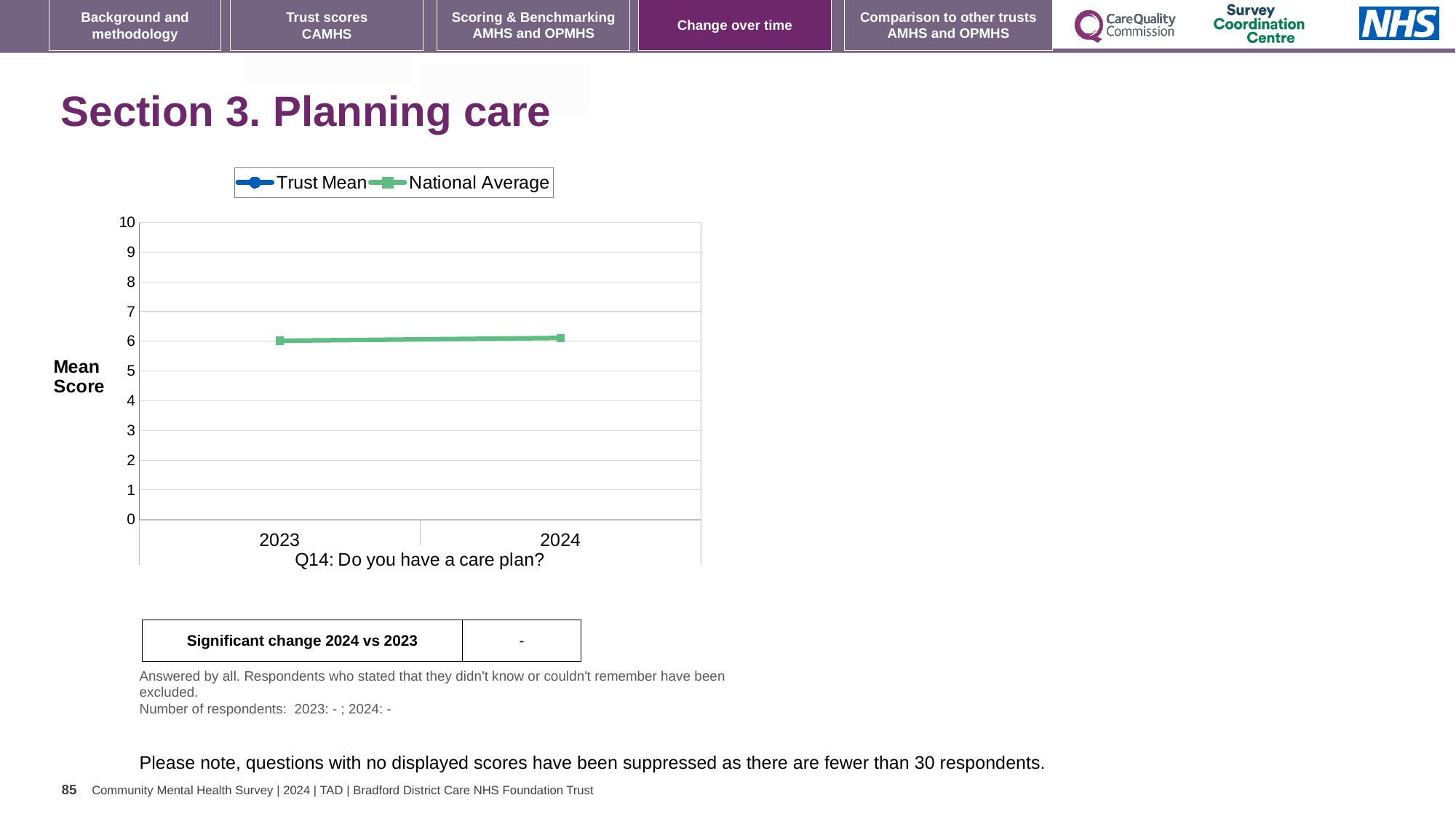
Which series in the legend has no plotted line on the chart? Trust Mean Is the National Average value for 2024 greater or less than 5? greater How many years are shown on the x axis of the chart? 2 Is the National Average value for 2023 greater or less than 7? less How many series does the chart legend list? 2 Is the National Average value for 2024 greater or less than 7? less What kind of chart is shown on the slide? line chart Which two series are listed in the chart legend? Trust Mean and National Average Does the National Average line rise or fall from 2023 to 2024? rise Which years are shown on the x axis of the chart? 2023 and 2024